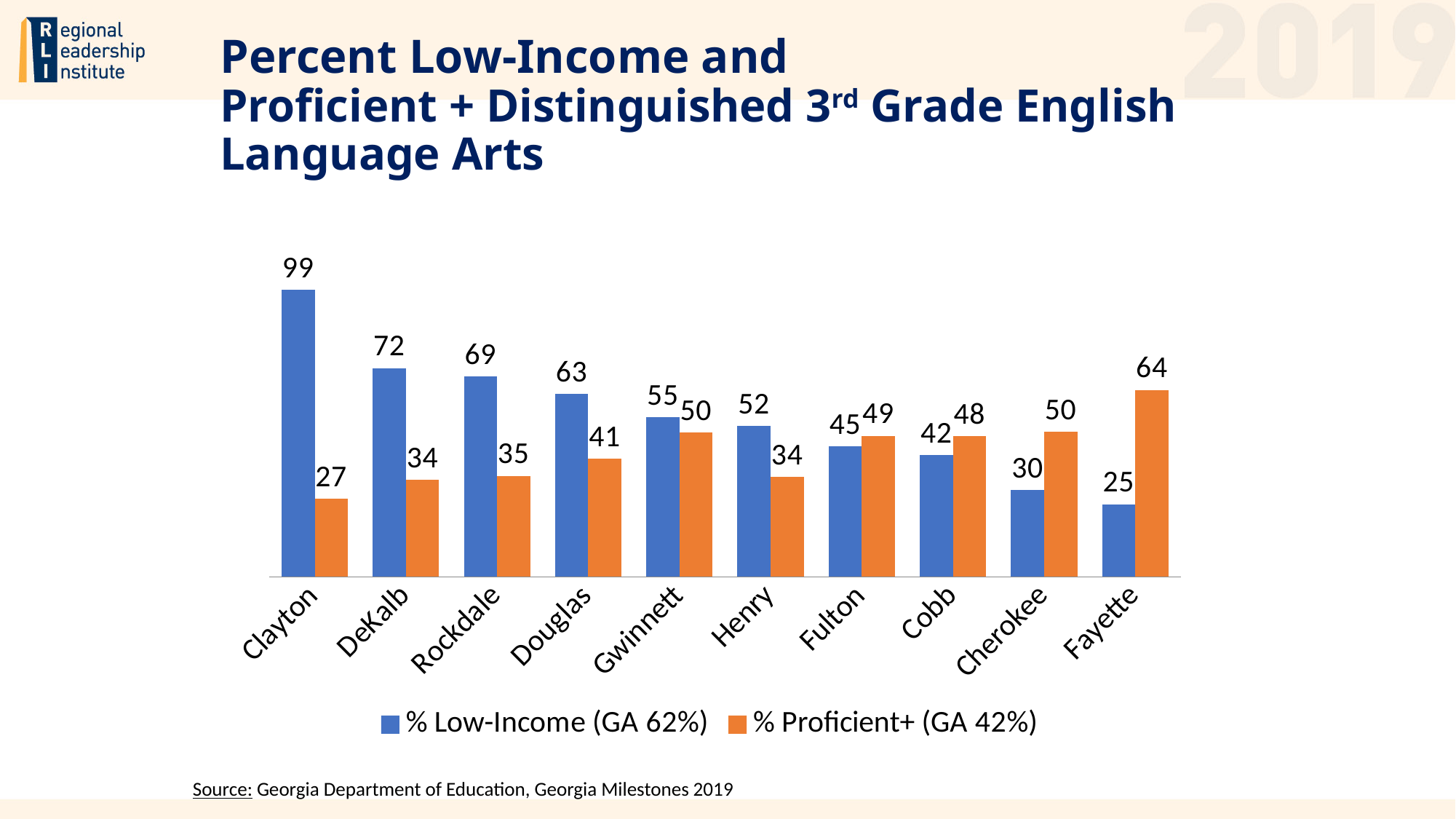
Does the % Low-Income series generally rise or fall from Clayton to Fayette? Fall Which county has the lowest % Proficient+ value? Clayton What is the difference between the % Low-Income and % Proficient+ values for DeKalb? 38 What is the % Low-Income value for Clayton? 99 What is the % Proficient+ value for Douglas? 41 How many counties are shown on the x axis? 10 How many series does the legend list? 2 Which is larger for Cherokee: % Low-Income or % Proficient+? % Proficient+ Which county has the highest % Low-Income value? Clayton What is the % Proficient+ value for Fayette? 64 What kind of chart is shown on the slide? Bar chart What Georgia statewide value is given in the legend for % Proficient+? 42%